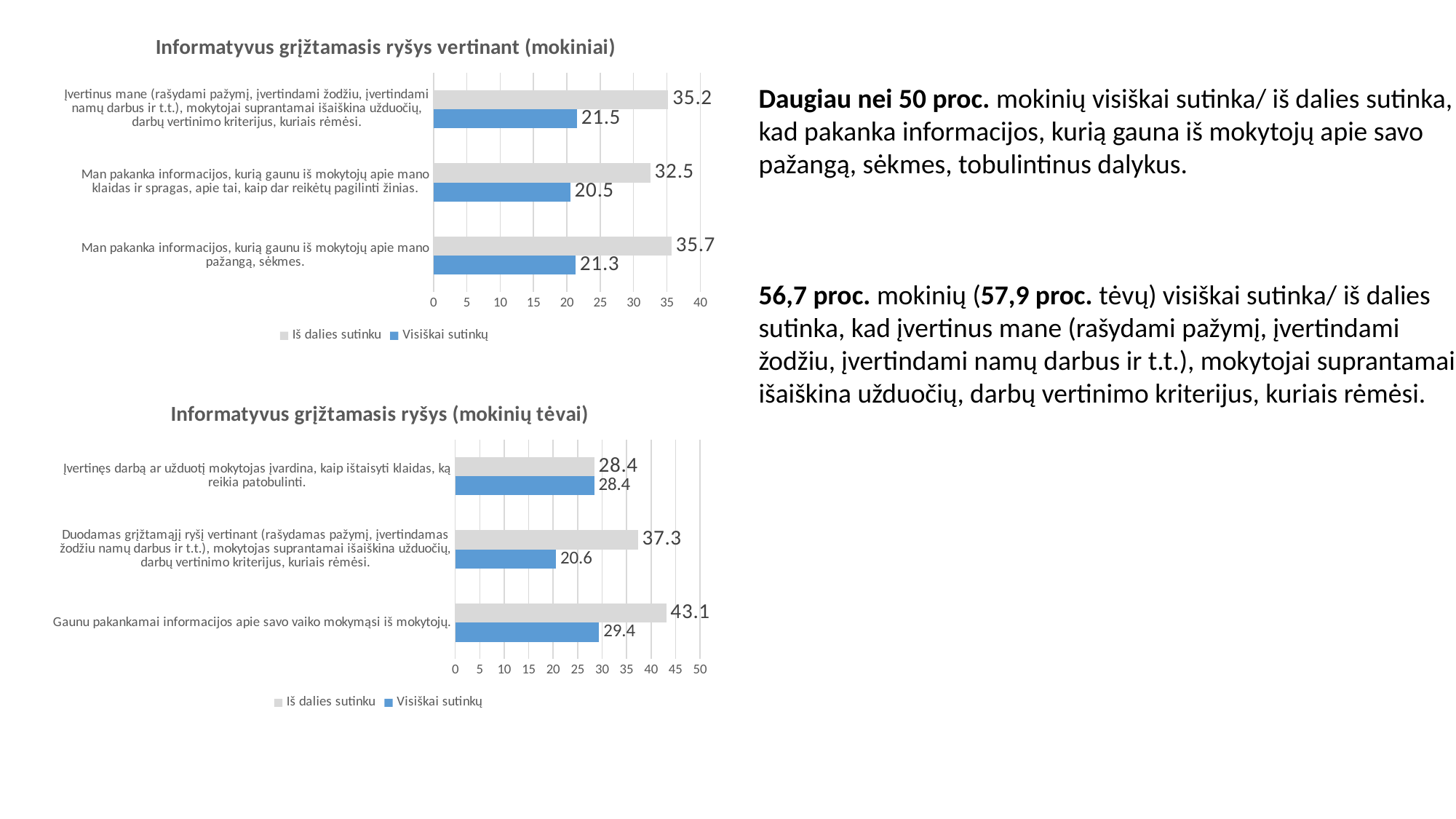
What type of chart is the chart titled "Informatyvus grįžtamasis ryšys vertinant (mokiniai)"? Bar chart In the chart titled "Informatyvus grįžtamasis ryšys (mokinių tėvai)", which category has the lowest "Visiškai sutinkų" value? Duodamas grįžtamąjį ryšį vertinant (rašydamas pažymį, įvertindamas žodžiu namų darbus ir t.t.), mokytojas suprantamai išaiškina užduočių, darbų vertinimo kriterijus, kuriais rėmėsi. In the chart titled "Informatyvus grįžtamasis ryšys vertinant (mokiniai)", how many categories are shown? 3 In the chart titled "Informatyvus grįžtamasis ryšys vertinant (mokiniai)", what is the "Visiškai sutinkų" value for "Man pakanka informacijos, kurią gaunu iš mokytojų apie mano klaidas ir spragas, apie tai, kaip dar reikėtų pagilinti žinias."? 20.5 In the chart titled "Informatyvus grįžtamasis ryšys vertinant (mokiniai)", which category has the highest "Iš dalies sutinku" value? Man pakanka informacijos, kurią gaunu iš mokytojų apie mano pažangą, sėkmes. In the chart titled "Informatyvus grįžtamasis ryšys (mokinių tėvai)", is the "Iš dalies sutinku" value for "Gaunu pakankamai informacijos apie savo vaiko mokymąsi iš mokytojų." larger than the "Visiškai sutinkų" value for the same category? Yes How many series does the legend list in the chart titled "Informatyvus grįžtamasis ryšys (mokinių tėvai)"? 2 In the chart titled "Informatyvus grįžtamasis ryšys (mokinių tėvai)", what is the difference between the "Iš dalies sutinku" and "Visiškai sutinkų" values for "Gaunu pakankamai informacijos apie savo vaiko mokymąsi iš mokytojų."? 13.7 In the chart titled "Informatyvus grįžtamasis ryšys vertinant (mokiniai)", what is the difference between the "Iš dalies sutinku" and "Visiškai sutinkų" values for "Įvertinus mane (rašydami pažymį, įvertindami žodžiu, įvertindami namų darbus ir t.t.), mokytojai suprantamai išaiškina užduočių, darbų vertinimo kriterijus, kuriais rėmėsi."? 13.7 In the chart titled "Informatyvus grįžtamasis ryšys (mokinių tėvai)", what is the "Visiškai sutinkų" value for "Duodamas grįžtamąjį ryšį vertinant (rašydamas pažymį, įvertindamas žodžiu namų darbus ir t.t.), mokytojas suprantamai išaiškina užduočių, darbų vertinimo kriterijus, kuriais rėmėsi."? 20.6 In the chart titled "Informatyvus grįžtamasis ryšys (mokinių tėvai)", what is the "Iš dalies sutinku" value for "Gaunu pakankamai informacijos apie savo vaiko mokymąsi iš mokytojų."? 43.1 In the chart titled "Informatyvus grįžtamasis ryšys vertinant (mokiniai)", what is the "Iš dalies sutinku" value for "Man pakanka informacijos, kurią gaunu iš mokytojų apie mano pažangą, sėkmes."? 35.7